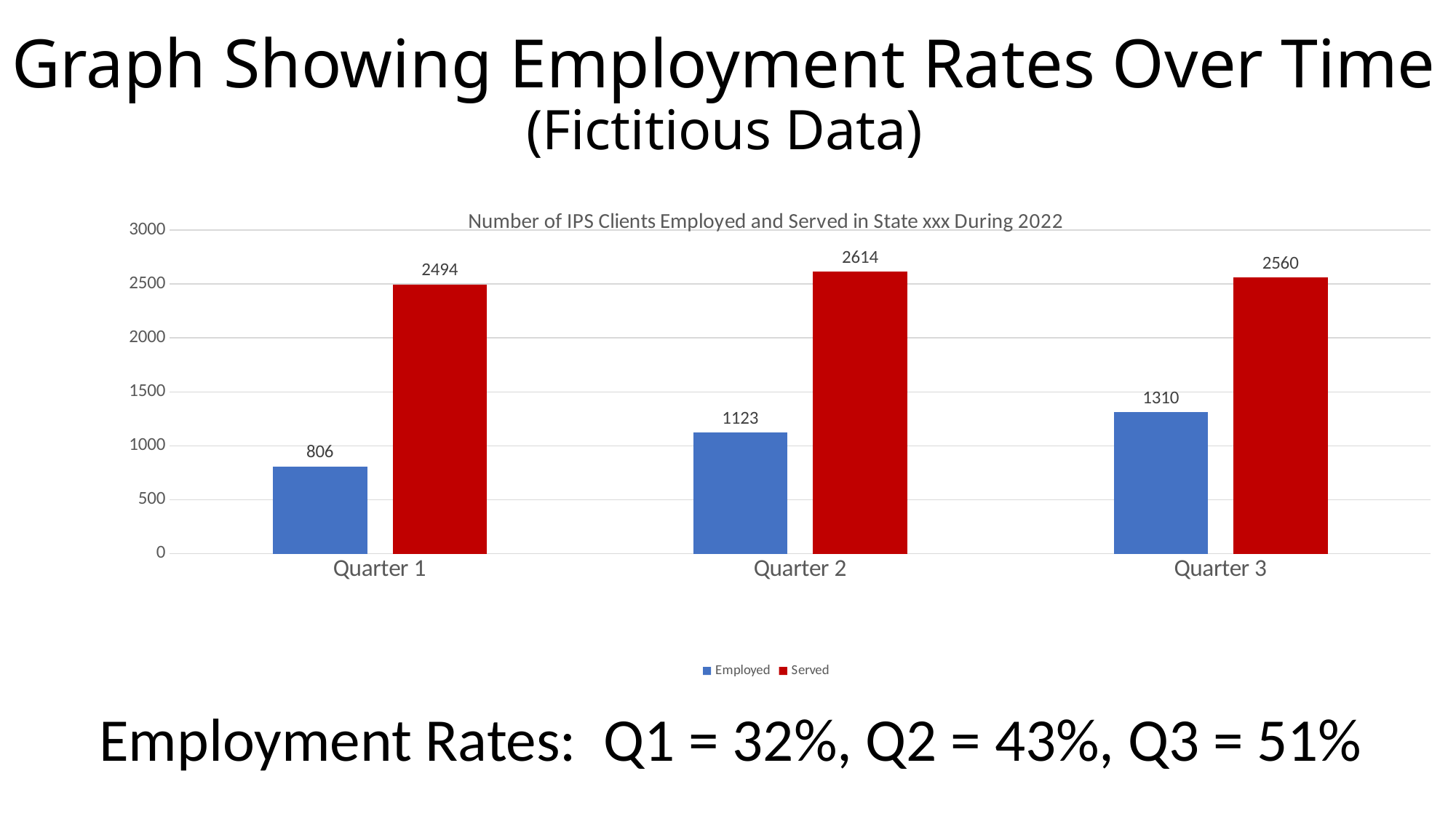
Which quarter has the highest Served value? Quarter 2 How many series does the legend list? 2 How many quarters are shown on the x axis? 3 Is the Employed value for Quarter 3 greater or less than 1500? less What is the Employed value for Quarter 1? 806 Which is larger, the Served value for Quarter 1 or the Served value for Quarter 3? Quarter 3 What is the Served value for Quarter 3? 2560 What is the difference between the Employed values for Quarter 3 and Quarter 2? 187 What is the difference between the Served and Employed values in Quarter 1? 1688 What is the Employed value for Quarter 2? 1123 Do the Employed values rise or fall from Quarter 1 to Quarter 3? rise Which quarter has the lowest Employed value? Quarter 1